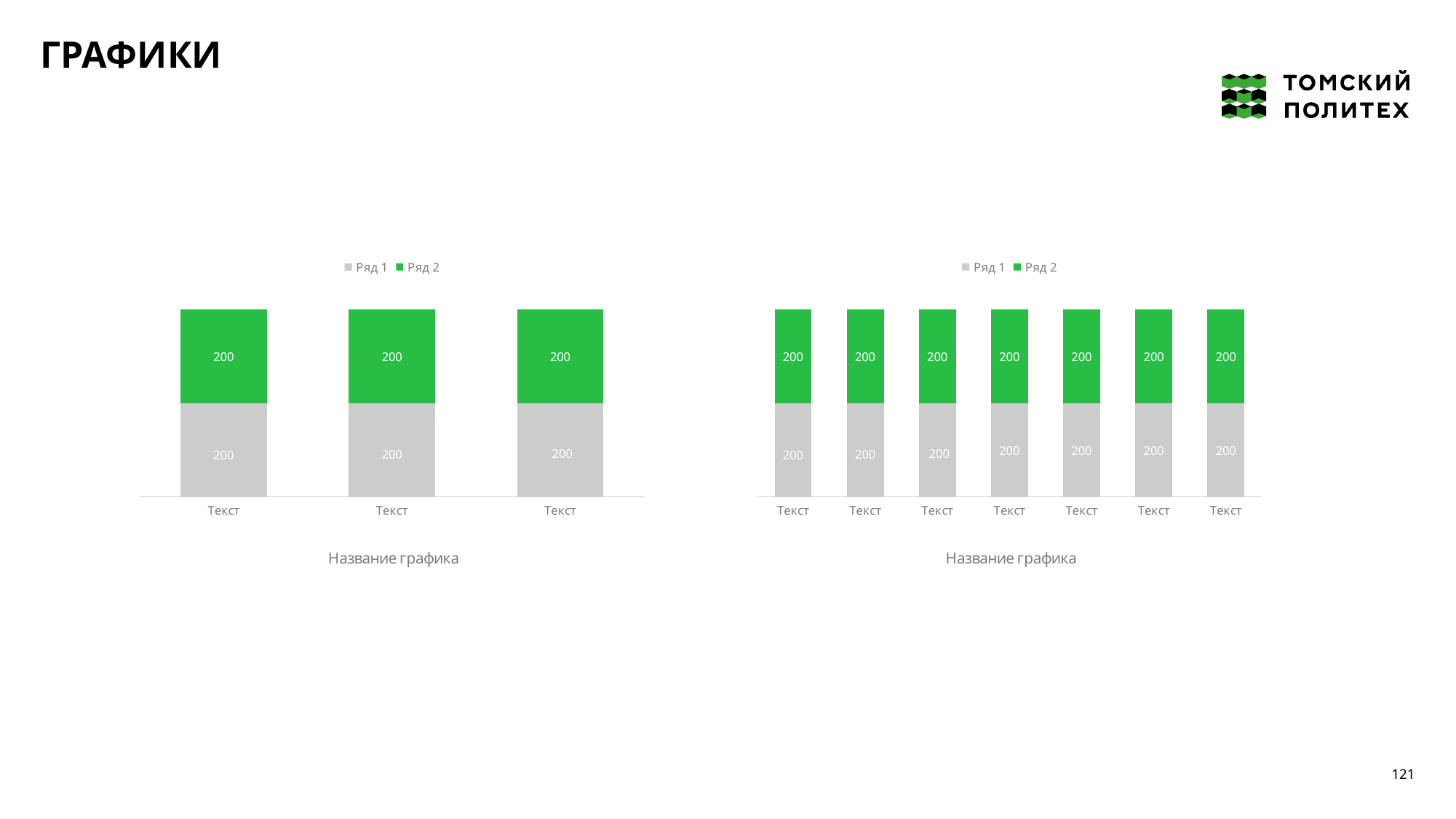
What kind of chart is the chart on the right of the slide? stacked bar chart How many bars does the chart on the left of the slide have? 3 How many series does the legend of the left chart list? 2 What are the two legend entries of the right chart? Ряд 1 and Ряд 2 How many bars does the chart on the right of the slide have? 7 What kind of chart is the chart on the left of the slide? stacked bar chart In the left chart, what is the difference between Ряд 1 and Ряд 2 in the first bar? 0 In the right chart, what is the total of the first (leftmost) stacked bar? 400 In the left chart, what is the total of the middle stacked bar? 400 In the right chart, what is the value of Ряд 1 for the last (rightmost) bar? 200 How many series does the legend of the right chart list? 2 In the left chart, what is the value of Ряд 2 for the first (leftmost) bar? 200